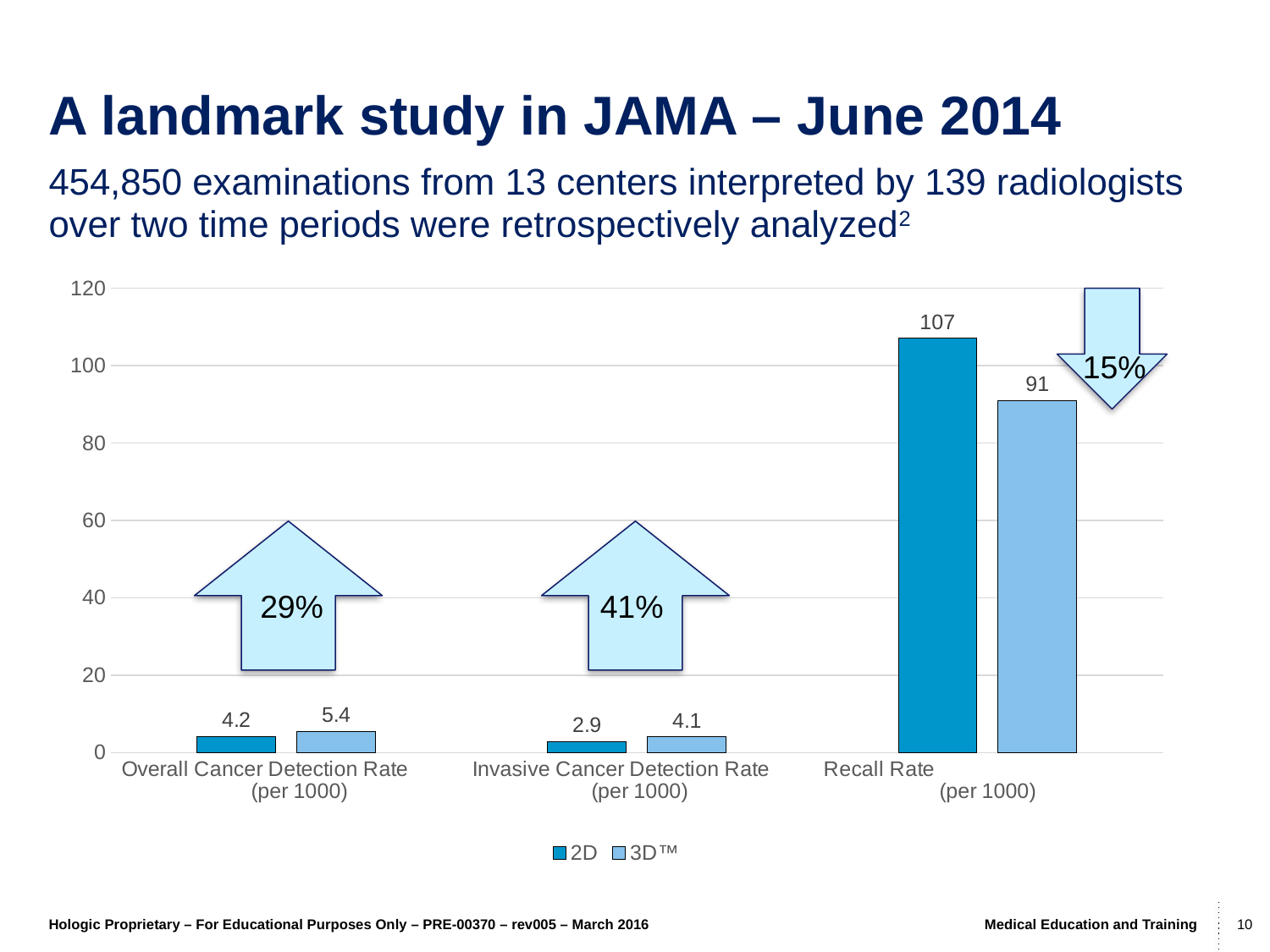
What is the difference between the 2D and 3D™ values for Recall Rate (per 1000)? 16 Which category has the highest 2D value? Recall Rate (per 1000) What is the 3D™ value for Overall Cancer Detection Rate (per 1000)? 5.4 What is the 3D™ value for Recall Rate (per 1000)? 91 Is the 2D value for Recall Rate (per 1000) greater or less than 100? greater For Invasive Cancer Detection Rate (per 1000), which is larger, the 2D value or the 3D™ value? 3D™ What is the 2D value for Overall Cancer Detection Rate (per 1000)? 4.2 What kind of chart is shown on the slide? bar chart Which category has the lowest 3D™ value? Invasive Cancer Detection Rate (per 1000) How many categories are shown on the x axis of the chart? 3 How many series does the chart legend list? 2 What is the 2D value for Invasive Cancer Detection Rate (per 1000)? 2.9